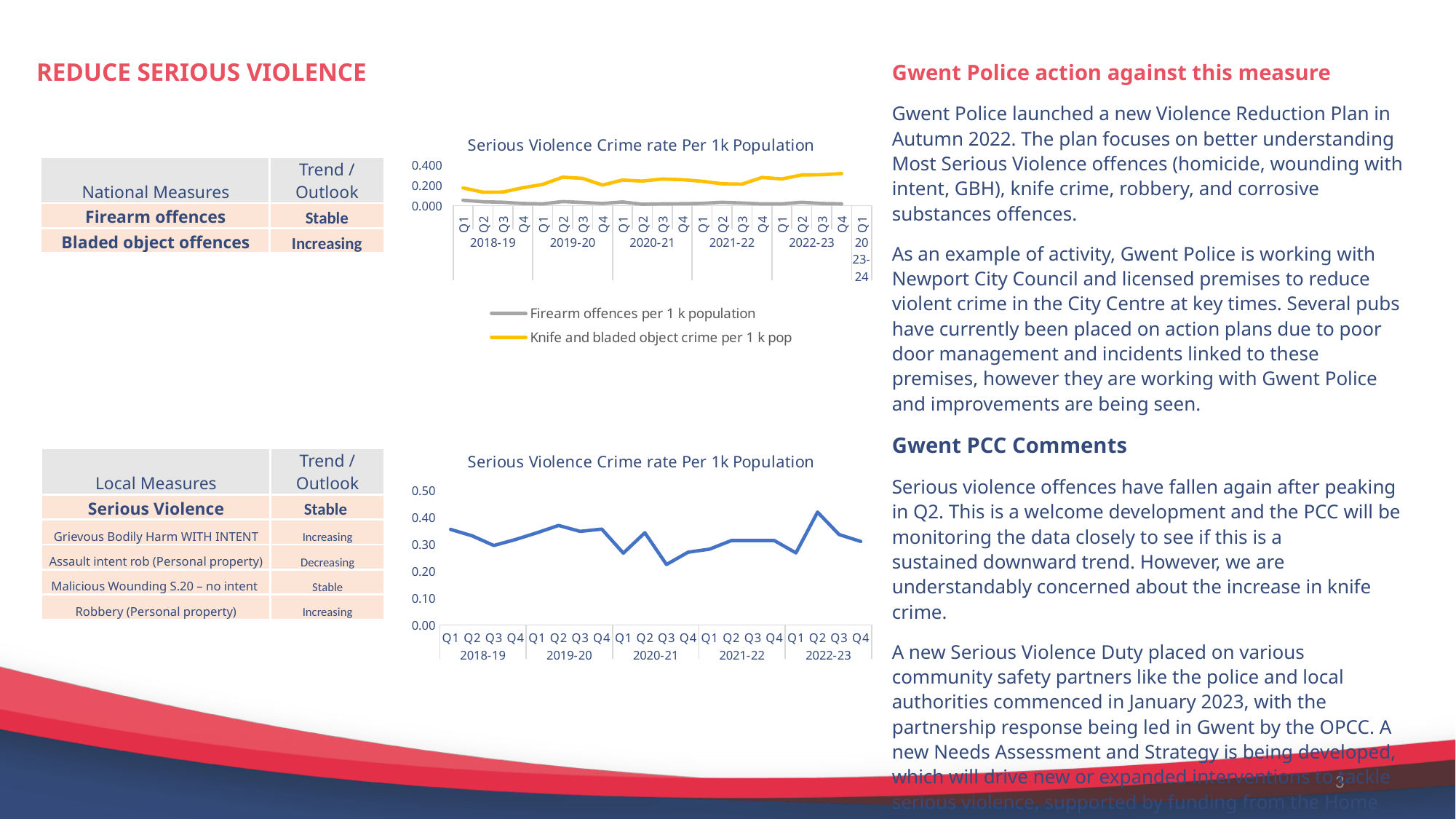
In the bottom chart, which quarter has the lowest value? Q3 2020-21 In the top chart, is the value for Firearm offences in Q1 2020-21 greater or less than 0.200? less How many series does the legend of the top chart list? 2 In the top chart, is the value for Knife and bladed object crime in Q4 2022-23 greater or less than 0.200? greater In the top chart, is the value for Knife and bladed object crime in Q2 2019-20 greater or less than 0.200? greater In the bottom chart, do the values rise or fall from Q2 2022-23 to Q4 2022-23? fall In the top chart, which series is plotted in yellow? Knife and bladed object crime per 1 k pop In the top chart, which series has the higher values throughout, firearm offences or knife and bladed object crime? Knife and bladed object crime per 1 k pop What kind of chart is the top chart on the slide? line chart In the bottom chart, which quarter has the highest value? Q2 2022-23